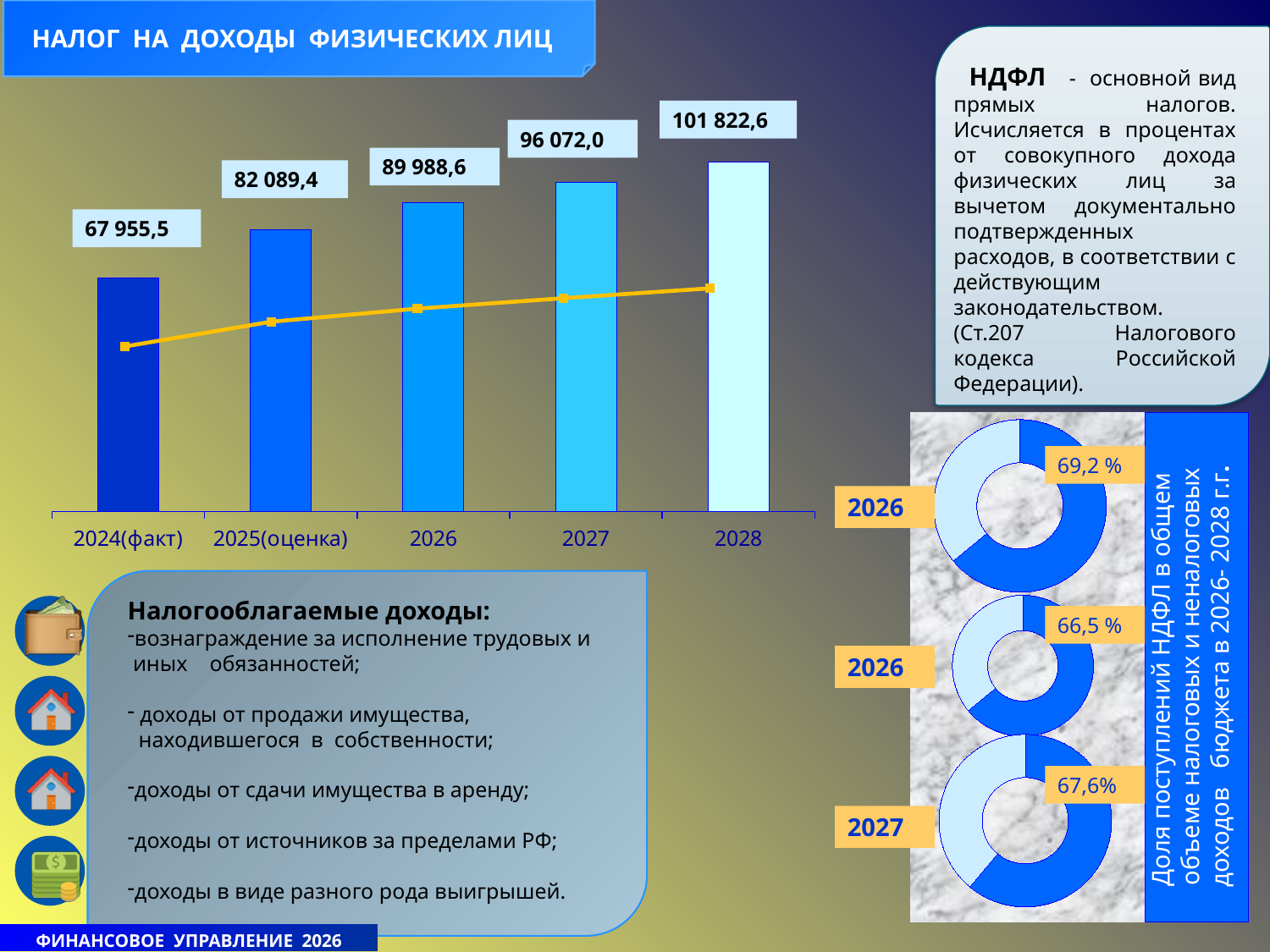
In the bar chart, do the values rise or fall from 2024(факт) to 2028? rise In the bar chart, which is larger: the value for 2026 or the value for 2025(оценка)? 2026 In the bar chart, which category has the lowest value? 2024(факт) In the bar chart, what is the value for 2025(оценка)? 82 089,4 In the bar chart, what is the value for 2027? 96 072,0 What percentage is shown on the bottom donut chart, labelled 2027? 67,6% In the bar chart, which year has the highest value? 2028 In the bar chart, what is the difference between the values for 2028 and 2027? 5 750,6 In the bar chart, what is the value for 2024(факт)? 67 955,5 What percentage is shown on the top donut chart on the right of the slide? 69,2 % What type of chart is the large chart on the left of the slide? bar chart How many bars are shown in the bar chart? 5